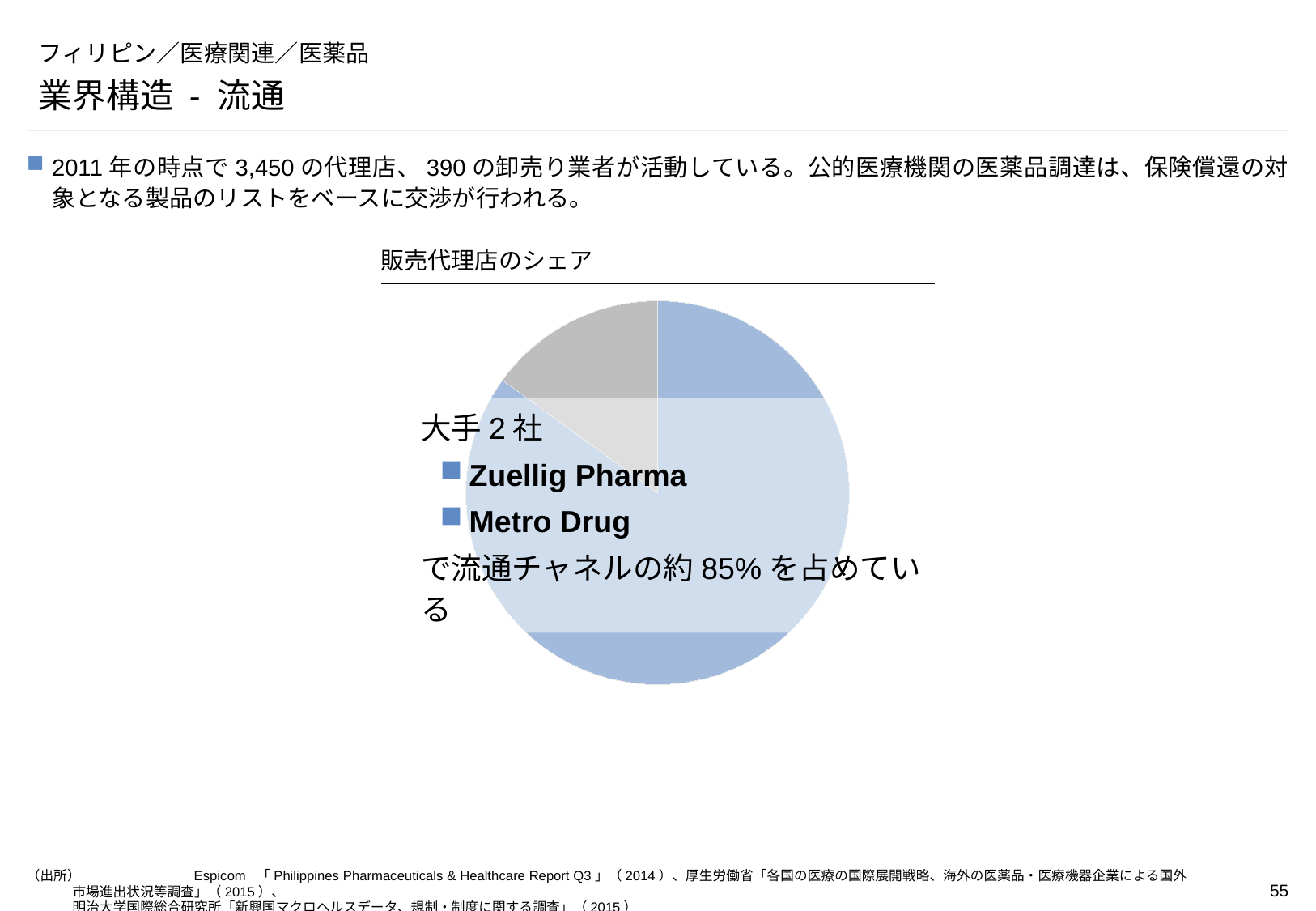
Which colour slice takes up the largest share of the pie chart? blue Does the pie chart display a legend? No What is the title of the pie chart? 販売代理店のシェア What kind of chart is shown on the slide? pie chart